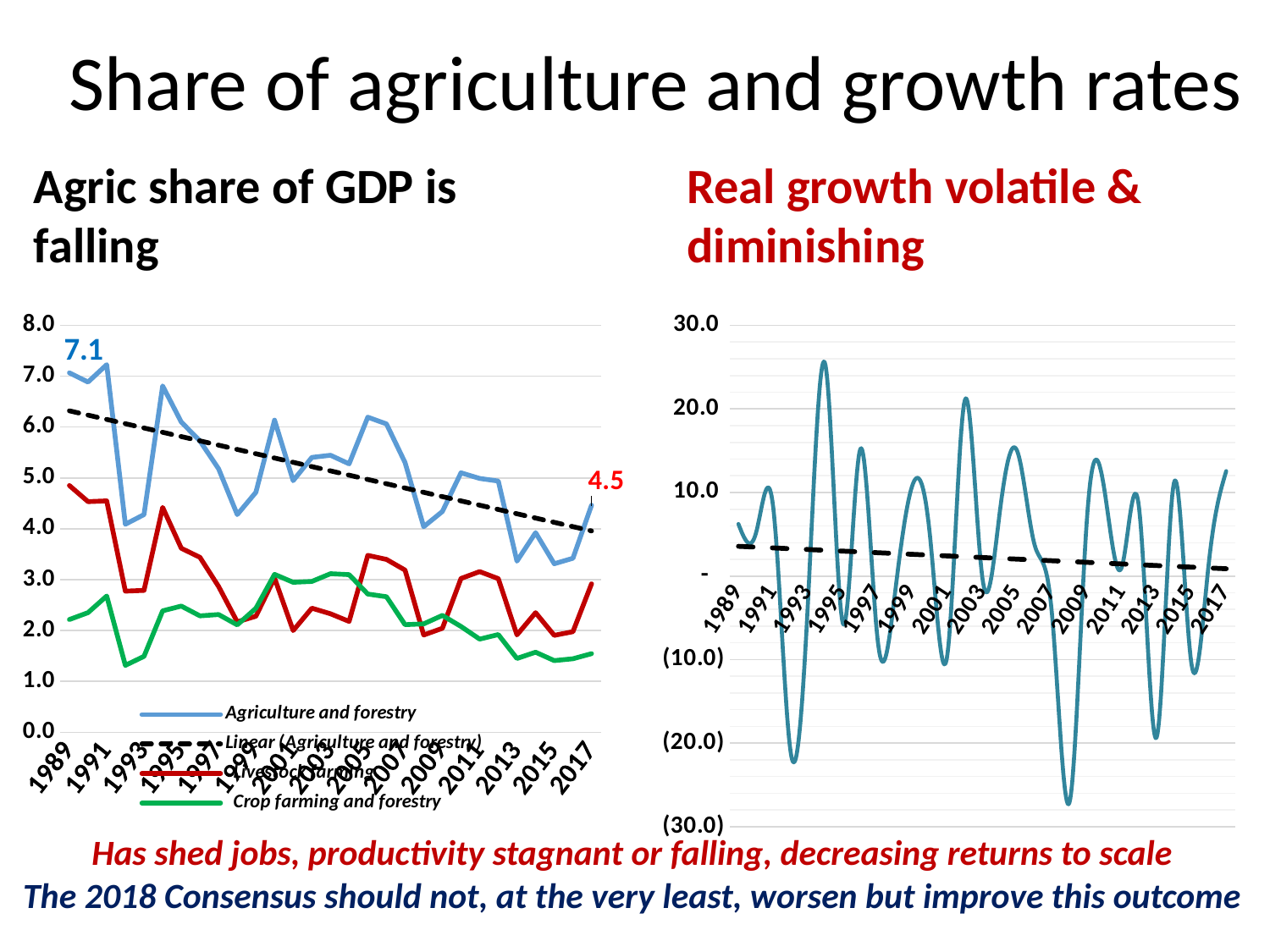
In the right chart 'Real growth volatile & diminishing', is the value for 1994 greater or less than 20.0? greater In the left chart 'Agric share of GDP is falling', what colour is the Livestock farming line? red In the left chart 'Agric share of GDP is falling', what is the value of Agriculture and forestry in 2017? 4.5 In the left chart 'Agric share of GDP is falling', how many entries does the legend list? 4 What kind of chart is the left chart, 'Agric share of GDP is falling'? line chart In the left chart 'Agric share of GDP is falling', is the value for Livestock farming in 1989 greater or less than 4.0? greater What kind of chart is the right chart, 'Real growth volatile & diminishing'? line chart In the left chart 'Agric share of GDP is falling', which series has the highest value in 1989? Agriculture and forestry In the left chart 'Agric share of GDP is falling', which is larger in 1989: Livestock farming or Crop farming and forestry? Livestock farming In the left chart 'Agric share of GDP is falling', does the Agriculture and forestry series generally rise or fall from 1989 to 2017? fall In the left chart 'Agric share of GDP is falling', by how much did the Agriculture and forestry value fall from 1989 to 2017? 2.6 In the left chart 'Agric share of GDP is falling', what is the value of Agriculture and forestry in 1989? 7.1